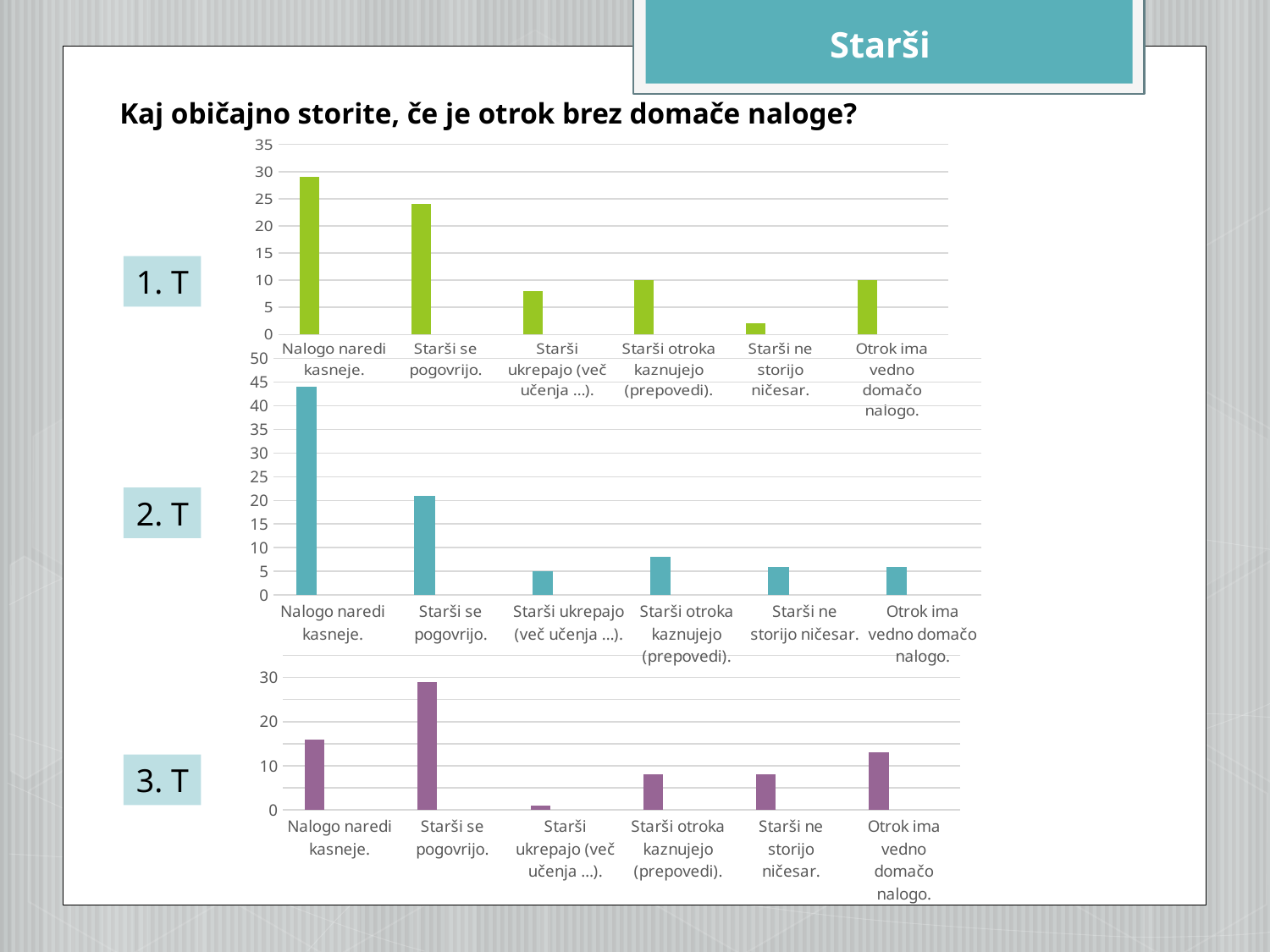
In the 3. T chart, is the value for Otrok ima vedno domačo nalogo greater or less than 10? greater In the 3. T chart, which category has the lowest value? Starši ukrepajo (več učenja ...). In the 2. T chart, which is larger, Starši se pogovrijo or Starši otroka kaznujejo (prepovedi)? Starši se pogovrijo. In the 3. T chart, which category has the highest value? Starši se pogovrijo. In the 2. T chart, which category has the highest value? Nalogo naredi kasneje. In the 1. T chart, which category has the highest value? Nalogo naredi kasneje. What type of chart is the 2. T chart? Bar chart In the 1. T chart, is the value for Starši ukrepajo (več učenja ...) greater or less than 10? less In the 2. T chart, is the value for Nalogo naredi kasneje greater or less than 40? greater How many categories are shown in the 3. T chart? 6 In the 1. T chart, which category has the lowest value? Starši ne storijo ničesar.